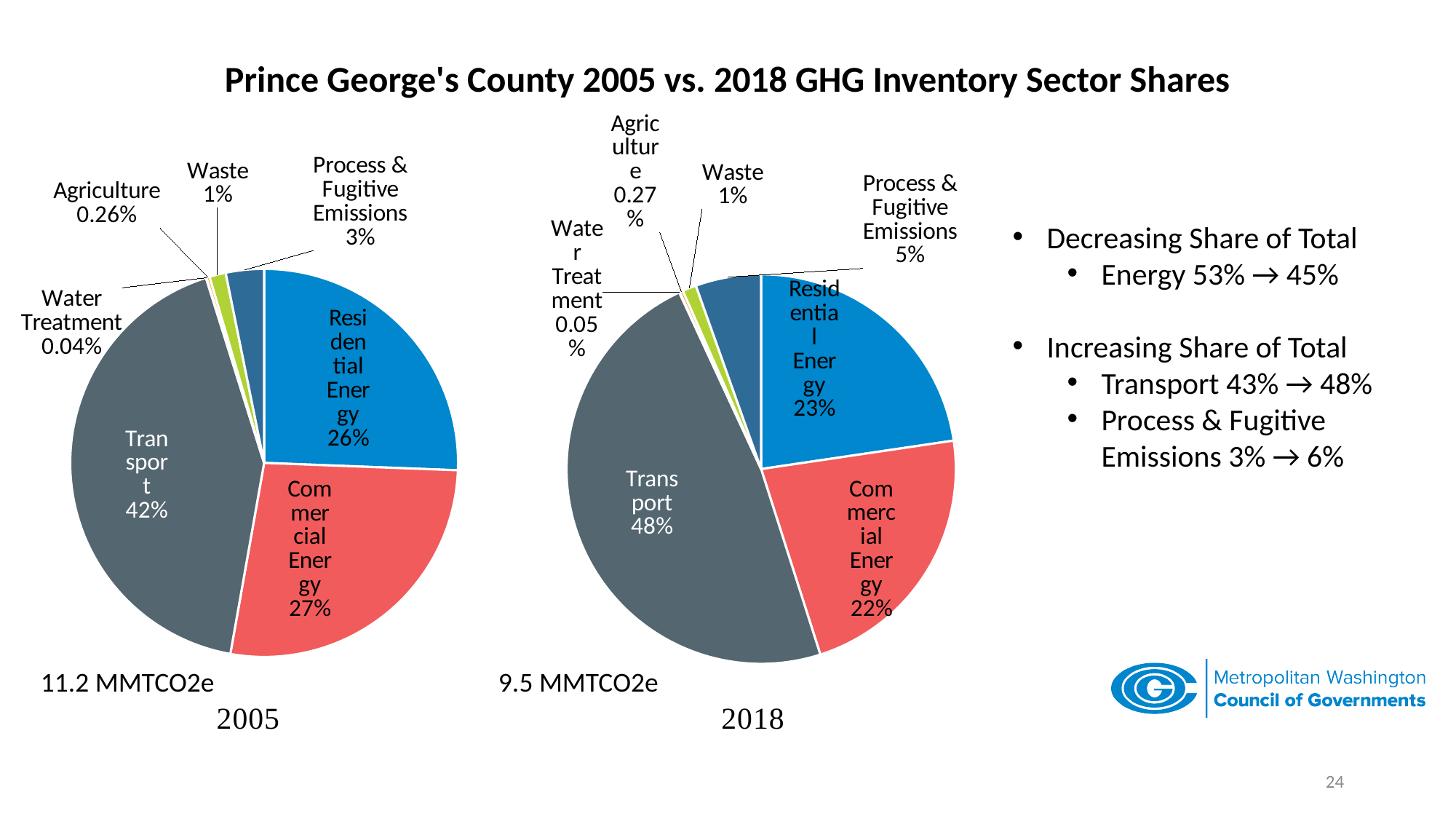
In the 2005 pie chart, what share does Water Treatment have? 0.04% What is the difference between the Transport share in the 2018 pie chart and the Transport share in the 2005 pie chart? 6% How many sectors are shown in the 2018 pie chart? 7 In the 2005 pie chart, what share does Transport have? 42% In the 2018 pie chart, what share does Residential Energy have? 23% In the 2005 pie chart, what share does Commercial Energy have? 27% What type of chart is used for the 2005 data? Pie chart In the 2005 pie chart, which is larger: Residential Energy or Commercial Energy? Commercial Energy In the 2018 pie chart, what share does Transport have? 48% In the 2018 pie chart, what share does Process & Fugitive Emissions have? 5% In the 2018 pie chart, which sector has the largest share? Transport In the 2005 pie chart, which sector has the smallest share? Water Treatment